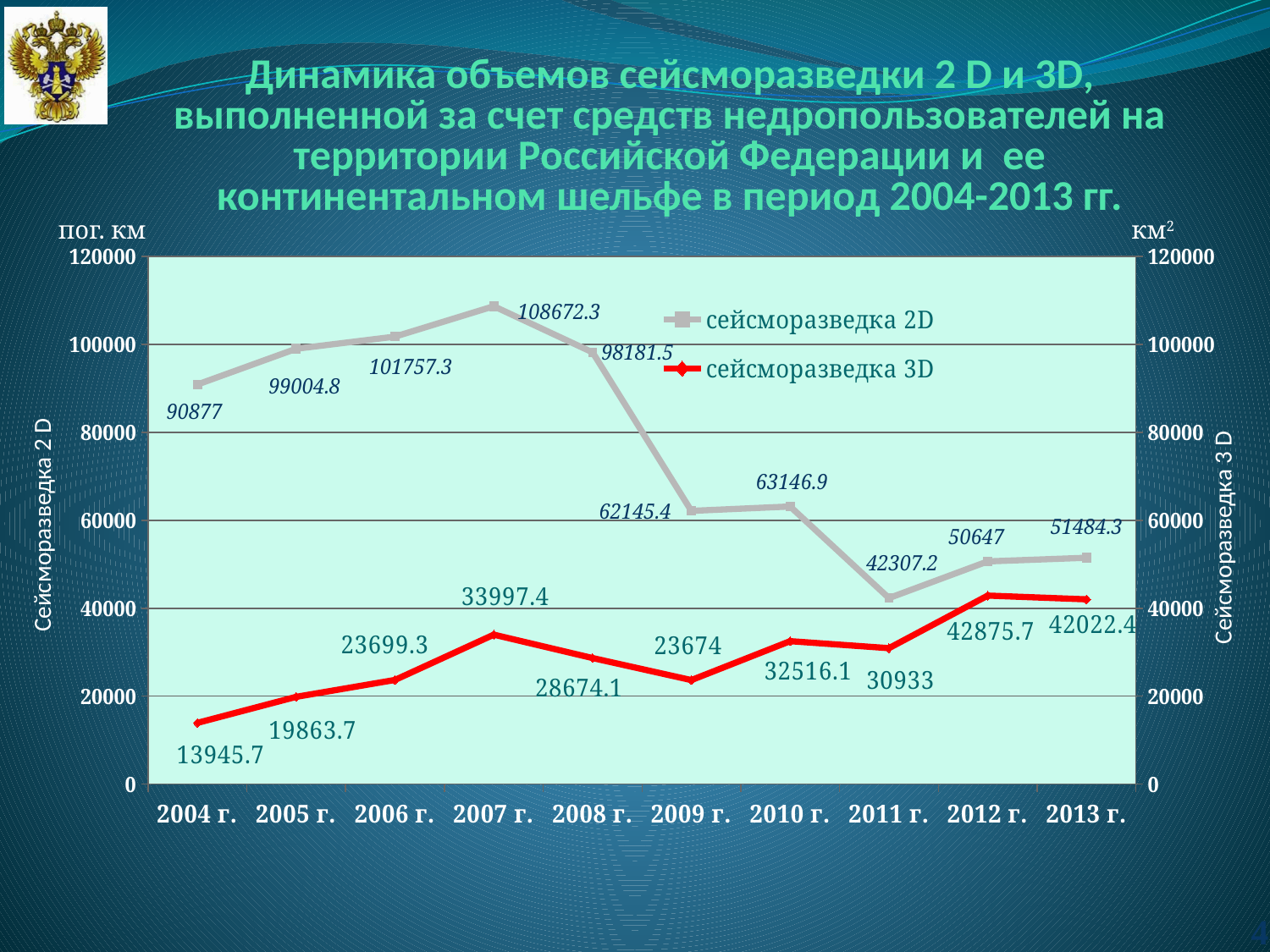
How many years are plotted along the x axis? 10 What is the value of сейсморазведка 3D in 2012 г.? 42875.7 In which year is сейсморазведка 2D at its highest? 2007 г. What is the difference between сейсморазведка 2D in 2004 г. and in 2011 г.? 48569.8 What is the value of сейсморазведка 2D in 2007 г.? 108672.3 What type of chart is shown on the slide? line chart Does сейсморазведка 2D rise or fall from 2008 г. to 2011 г.? fall How many series does the legend list? 2 In which year is сейсморазведка 2D at its lowest? 2011 г. What is the value of сейсморазведка 3D in 2004 г.? 13945.7 Which is larger: сейсморазведка 3D in 2007 г. or in 2008 г.? 2007 г. In which year is сейсморазведка 3D at its lowest? 2004 г.